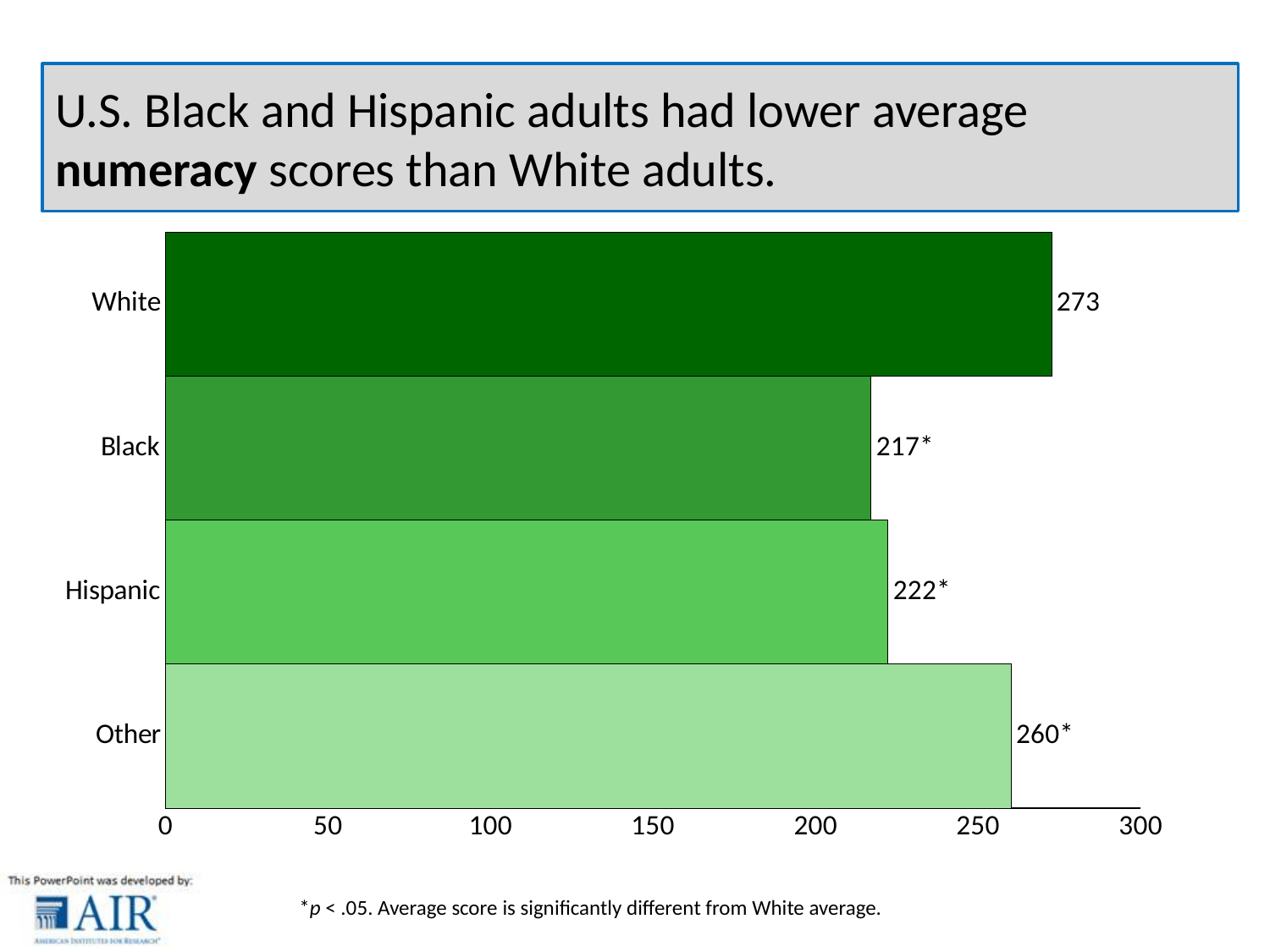
Which group has the highest average numeracy score? White What is the average numeracy score for Black adults? 217* What is the maximum value shown on the horizontal axis? 300 What kind of chart is shown on the slide? Bar chart Which group has the lowest average numeracy score? Black What is the average numeracy score for White adults? 273 What is the average numeracy score for Hispanic adults? 222* What is the average numeracy score for the Other group? 260* What is the difference between the average numeracy scores of Hispanic and Black adults? 5 What is the difference between the average numeracy scores of White and Black adults? 56 How many groups are shown in the chart? 4 Which group has a higher average numeracy score, Hispanic or Other? Other